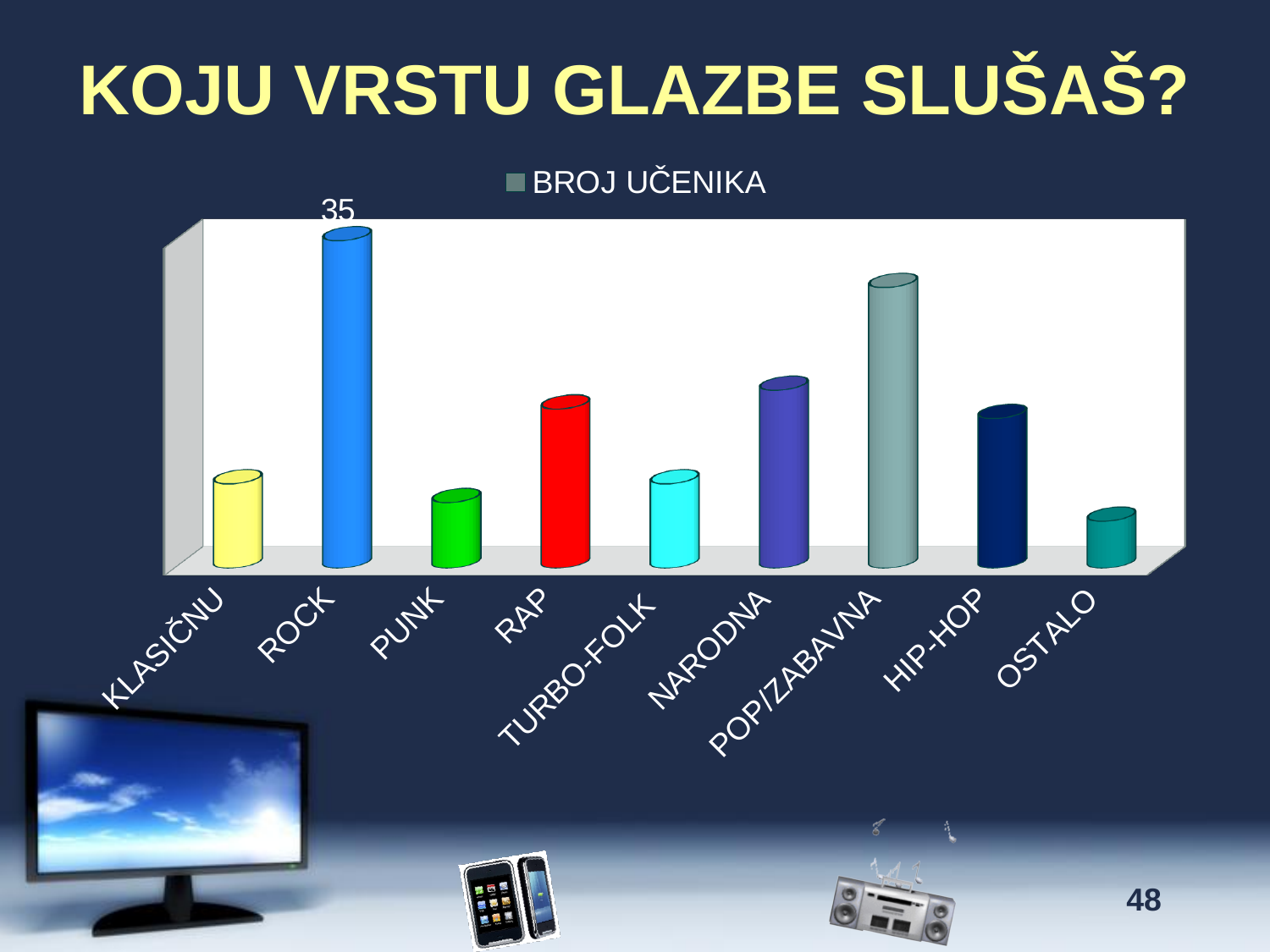
Which category has the highest value? ROCK Which is larger, the value for KLASIČNU or the value for ROCK? ROCK How many categories are shown in the chart? 9 How many series does the legend list? 1 Which is larger, the value for PUNK or the value for RAP? RAP Which is larger, the value for ROCK or the value for POP/ZABAVNA? ROCK What kind of chart is shown on the slide? bar chart What is the value for ROCK? 35 What is the title of the slide? KOJU VRSTU GLAZBE SLUŠAŠ? What is the name of the series shown in the legend? BROJ UČENIKA